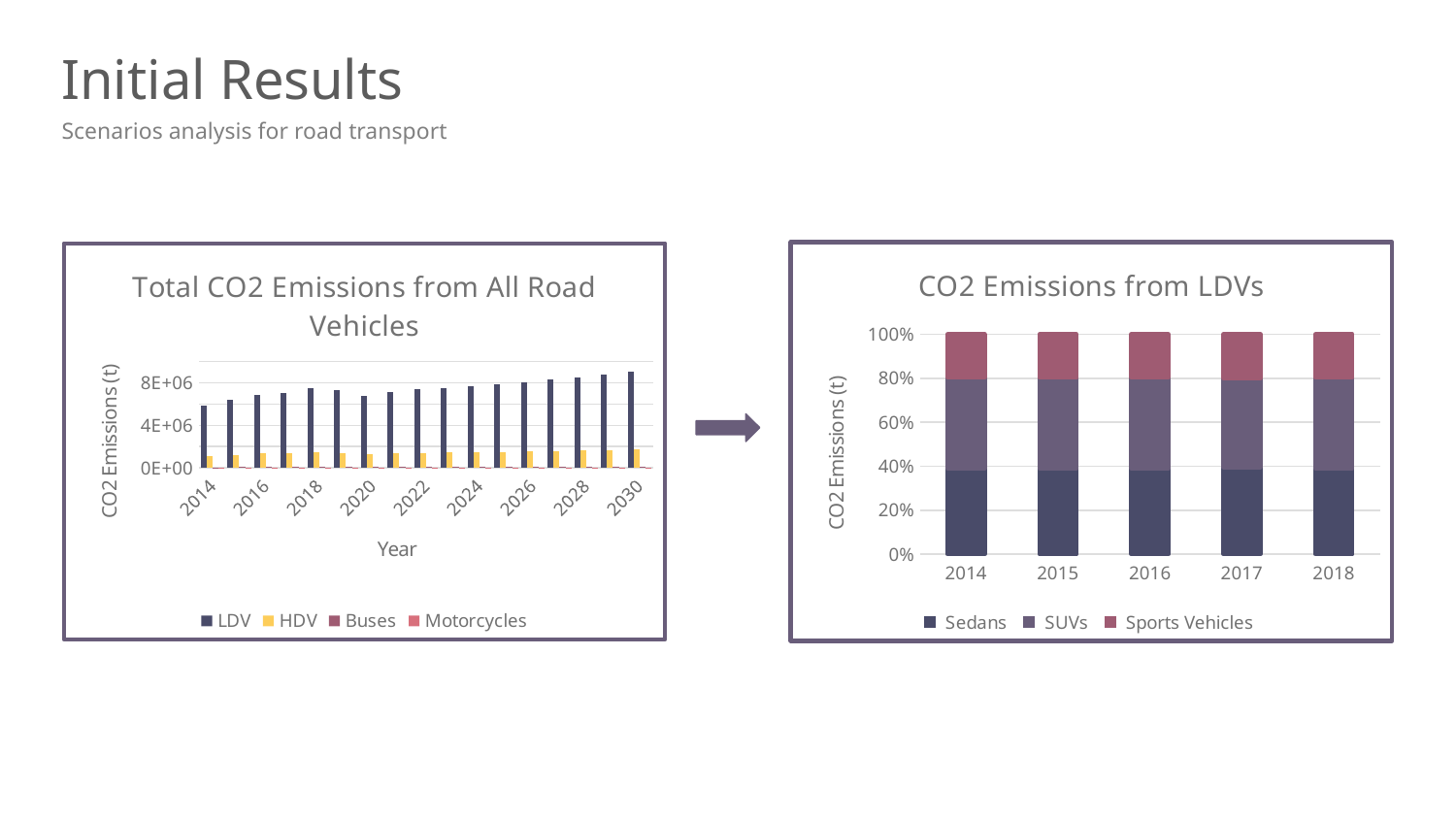
How many series does the legend of the 'CO2 Emissions from LDVs' chart list? 3 How many years are shown on the x axis of the 'CO2 Emissions from LDVs' chart? 5 In the 'Total CO2 Emissions from All Road Vehicles' chart, which year has the highest LDV value? 2030 In the 'Total CO2 Emissions from All Road Vehicles' chart, do LDV emissions generally rise or fall from 2014 to 2030? rise In the 'Total CO2 Emissions from All Road Vehicles' chart, which is larger in 2014, LDV or HDV? LDV In the 'CO2 Emissions from LDVs' chart, is the Sedans share for 2014 greater or less than 60%? less What kind of chart is the 'CO2 Emissions from LDVs' chart? stacked bar chart In the 'Total CO2 Emissions from All Road Vehicles' chart, is the LDV value for 2014 greater or less than 4E+06? greater What kind of chart is the 'Total CO2 Emissions from All Road Vehicles' chart? bar chart What is the label on the y axis of the 'CO2 Emissions from LDVs' chart? CO2 Emissions (t) In the 'Total CO2 Emissions from All Road Vehicles' chart, is the HDV value for 2030 greater or less than 4E+06? less How many series does the legend of the 'Total CO2 Emissions from All Road Vehicles' chart list? 4